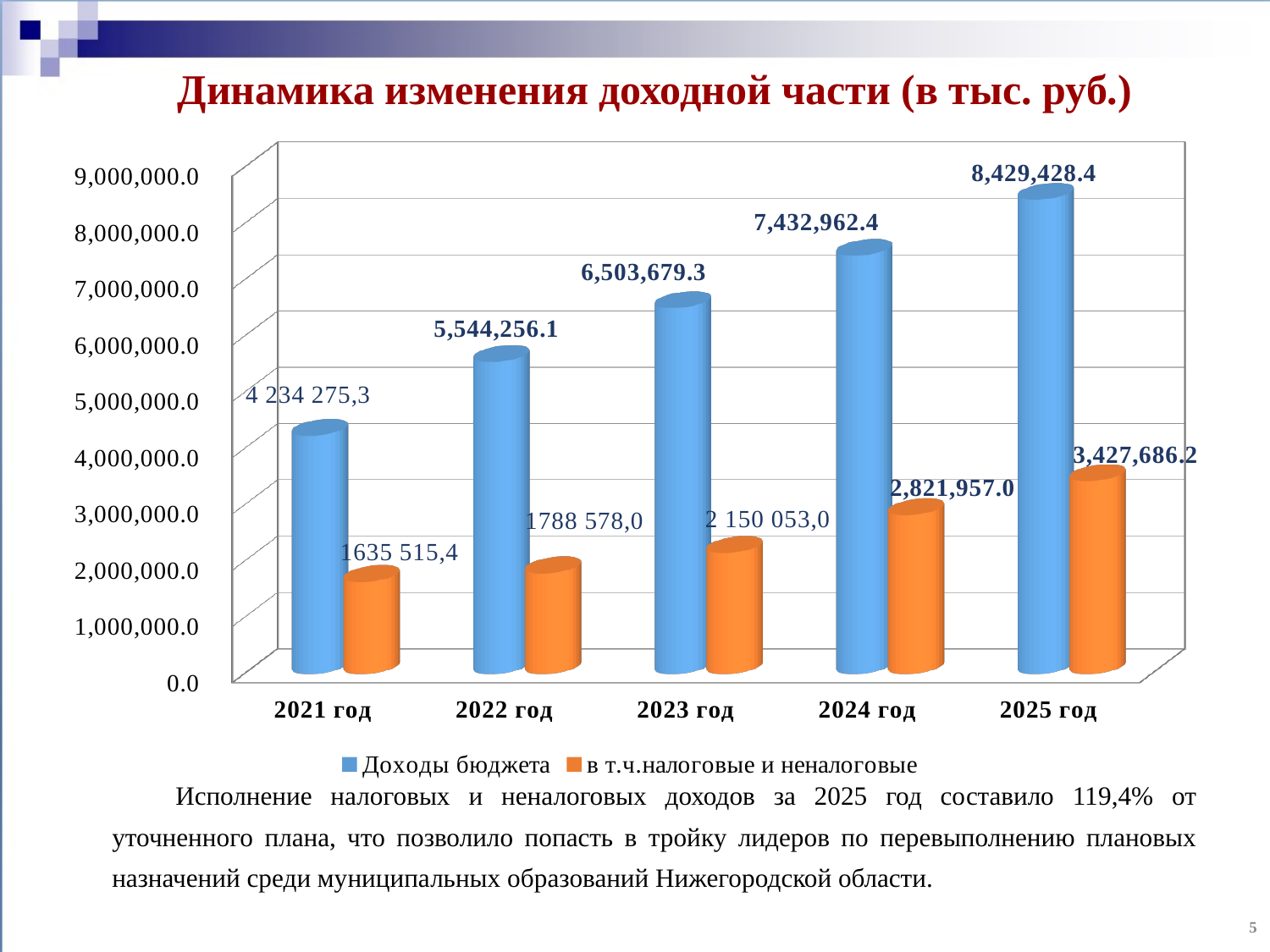
How many series does the legend list? 2 What is the value of в т.ч.налоговые и неналоговые for 2021 год? 1635 515,4 Which is larger: Доходы бюджета in 2023 год or в т.ч.налоговые и неналоговые in 2025 год? Доходы бюджета in 2023 год What is the value of Доходы бюджета for 2022 год? 5,544,256.1 Which year has the highest value of Доходы бюджета? 2025 год Do the values of Доходы бюджета rise or fall from 2021 год to 2025 год? rise What is the value of Доходы бюджета for 2025 год? 8,429,428.4 Which year has the lowest value of в т.ч.налоговые и неналоговые? 2021 год What is the difference between Доходы бюджета in 2025 год and 2024 год? 996,466.0 What is the value of в т.ч.налоговые и неналоговые for 2024 год? 2,821,957.0 How many years are shown on the x axis? 5 Is the value of Доходы бюджета for 2021 год greater or less than 5,000,000.0? less